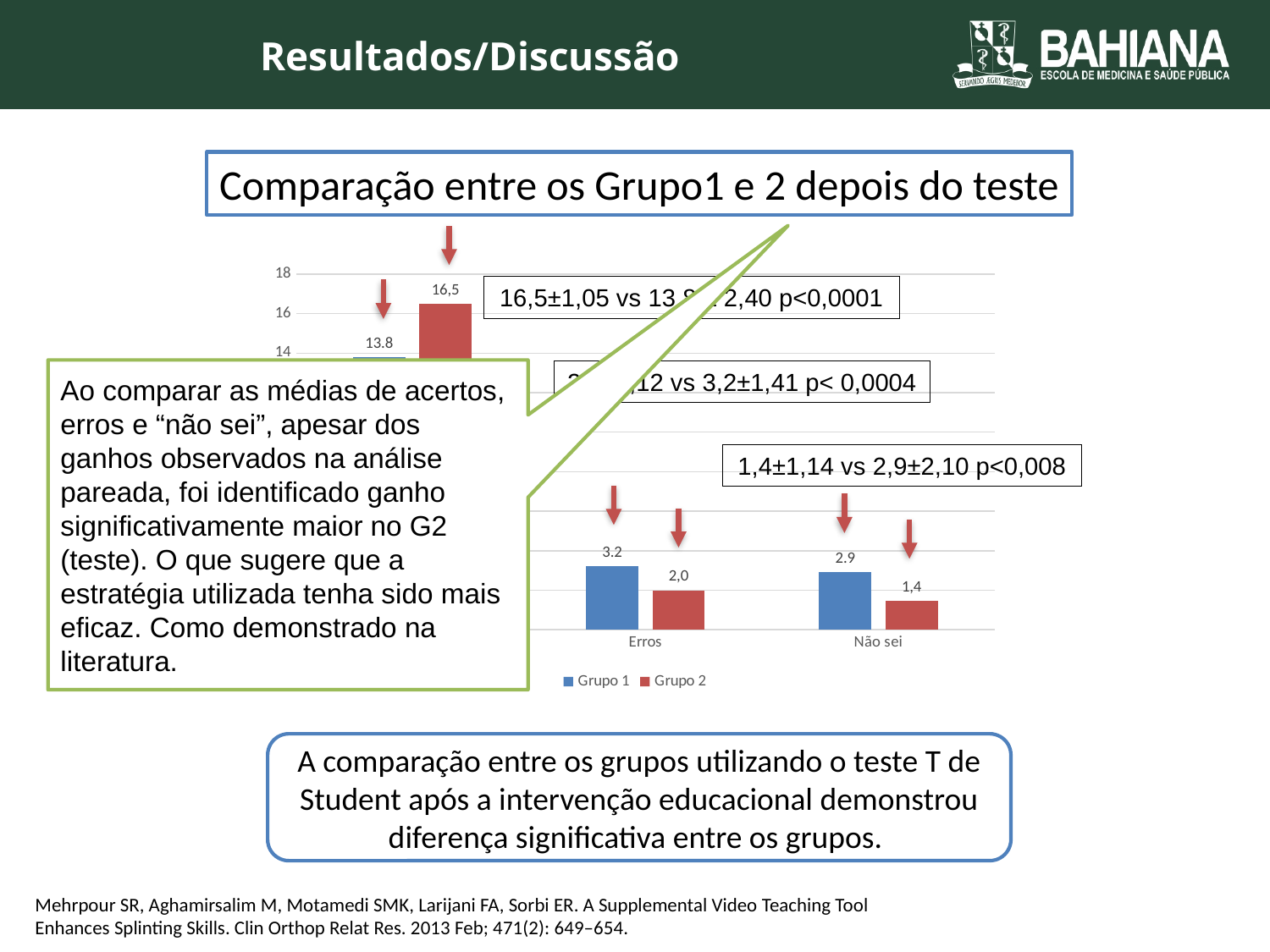
What is the difference between the Grupo 1 and Grupo 2 values in the Erros category? 1,2 How many series does the chart legend list? 2 What kind of chart is shown on the slide? bar chart What is the difference between the Grupo 1 and Grupo 2 values in the Não sei category? 1,5 What is the value for Grupo 2 in the Erros category? 2,0 What is the value for Grupo 1 in the Erros category? 3.2 In the Erros category, which group has the larger value, Grupo 1 or Grupo 2? Grupo 1 What is the title shown above the chart? Comparação entre os Grupo1 e 2 depois do teste Which series are listed in the chart legend? Grupo 1 and Grupo 2 What is the value for Grupo 2 in the Não sei category? 1,4 In the Não sei category, which group has the smaller value, Grupo 1 or Grupo 2? Grupo 2 What is the value for Grupo 1 in the Não sei category? 2.9